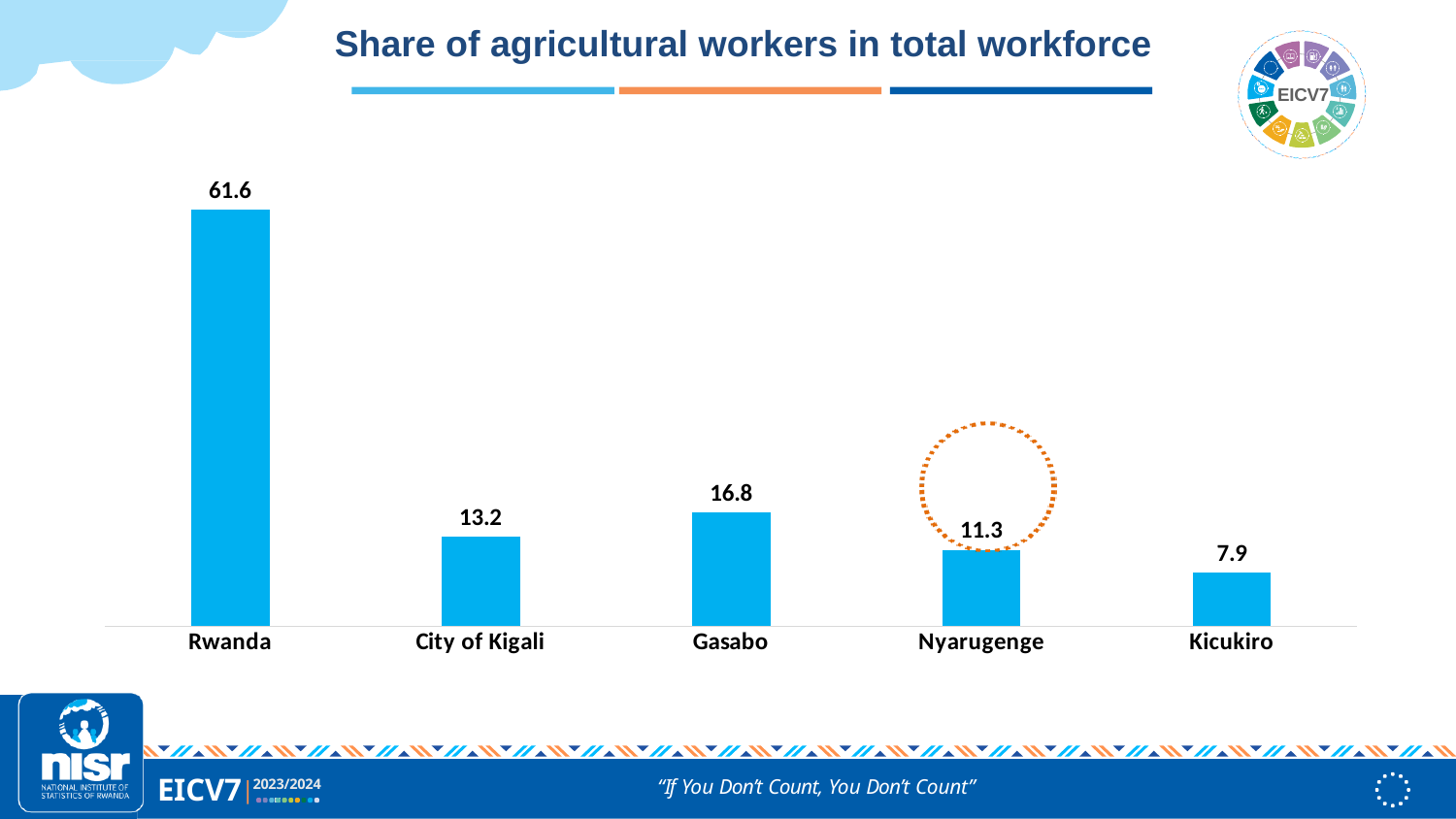
How many categories are shown on the chart? 5 Which category has the highest share of agricultural workers? Rwanda What is the difference between the values for Gasabo and Kicukiro? 8.9 What is the value shown for Gasabo? 16.8 What is the value shown for City of Kigali? 13.2 What is the share of agricultural workers in the total workforce for Rwanda? 61.6 Which category has the lowest share of agricultural workers? Kicukiro What is the value shown for Kicukiro? 7.9 Which has a larger value, Gasabo or Nyarugenge? Gasabo What is the value shown for Nyarugenge? 11.3 What type of chart is shown on the slide? Bar chart What is the difference between the values for Rwanda and City of Kigali? 48.4